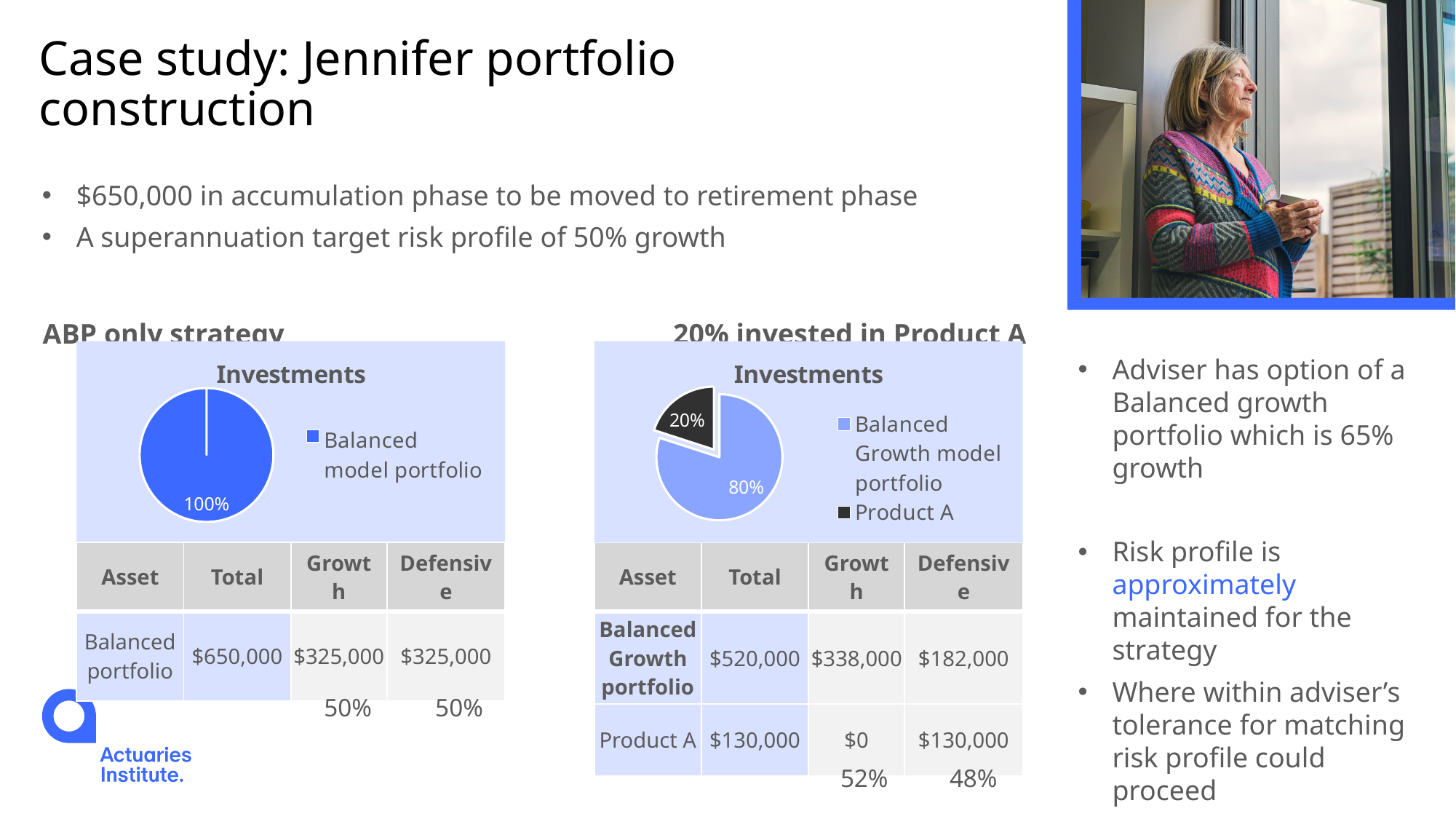
How many entries does the legend of the left pie chart (ABP only strategy) list? 1 In the right pie chart (20% invested in Product A), which slice is the largest? Balanced Growth model portfolio In the right pie chart (20% invested in Product A), what is the difference in percentage points between the Balanced Growth model portfolio slice and the Product A slice? 60 In the right pie chart (20% invested in Product A), which slice is the smallest? Product A How many slices does the right pie chart (20% invested in Product A) have? 2 What is the title of both pie charts on the slide? Investments In the right pie chart (20% invested in Product A), what share does Product A have? 20% How many slices does the left pie chart (ABP only strategy) have? 1 What kind of chart is shown under the 'ABP only strategy' heading on the left? pie chart In the right pie chart (20% invested in Product A), what share does the Balanced Growth model portfolio have? 80% In the right pie chart (20% invested in Product A), what colour is the Product A slice? black In the left pie chart (ABP only strategy), what share does the Balanced model portfolio have? 100%